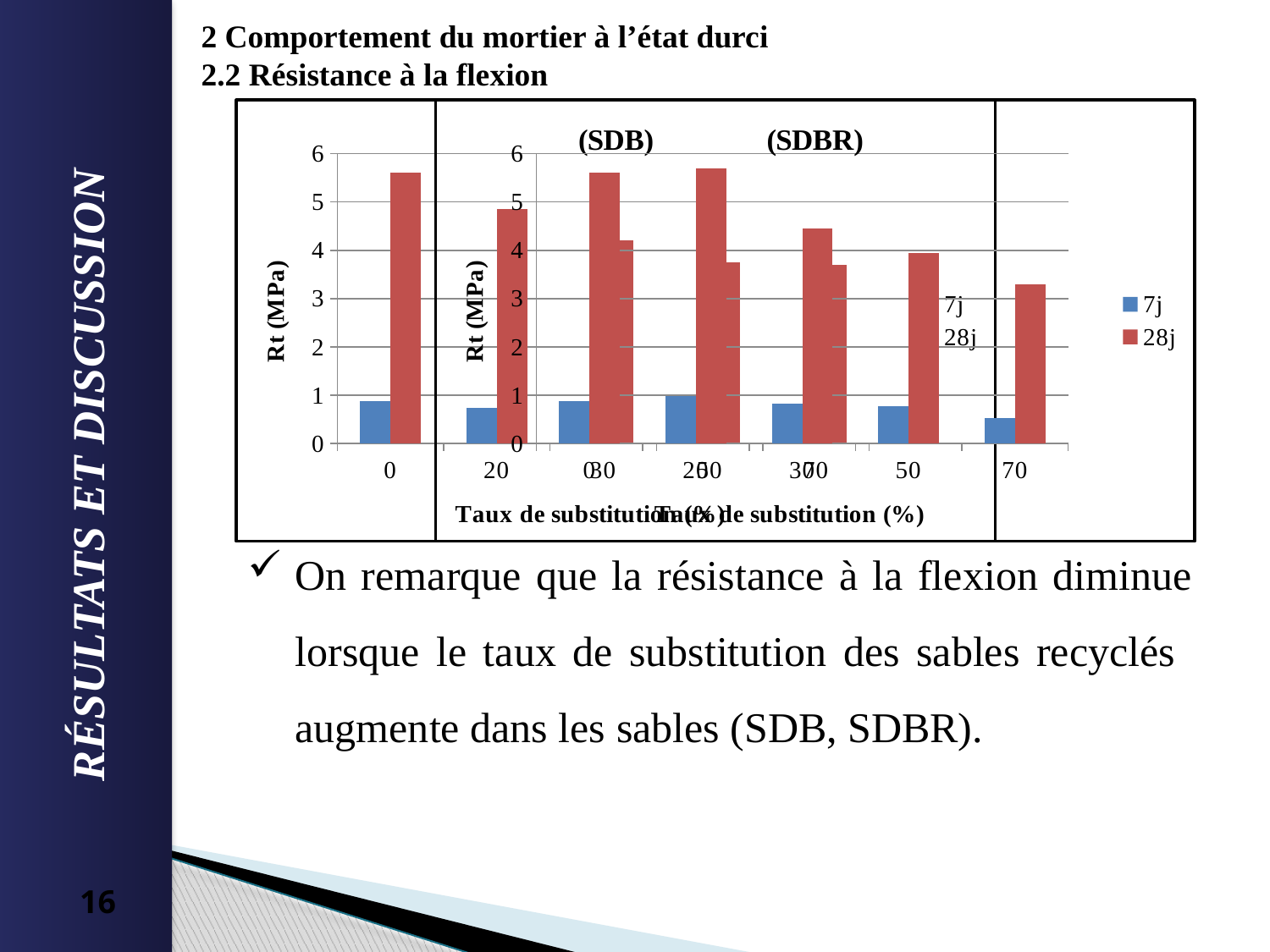
What is the label of the vertical axis? Rt (MPa) How many series does the legend list? 2 What kind of chart is shown on the slide? bar chart In the SDBR chart, is the 28j value at a substitution rate of 30 greater or less than 4? greater In the SDBR chart, do the 28j values generally rise or fall as the substitution rate increases? fall In the SDBR chart, how many substitution rate categories are shown on the x axis? 5 In the SDBR chart, which substitution rate has the lowest 28j value? 70 In the SDBR chart, is the 28j value at a substitution rate of 70 greater or less than 4? less What are the two series named in the legend? 7j and 28j In the SDBR chart, is the 28j value at a substitution rate of 0 greater or less than 5? greater In the SDBR chart, which is larger, the 28j value at a substitution rate of 0 or at 70? 0